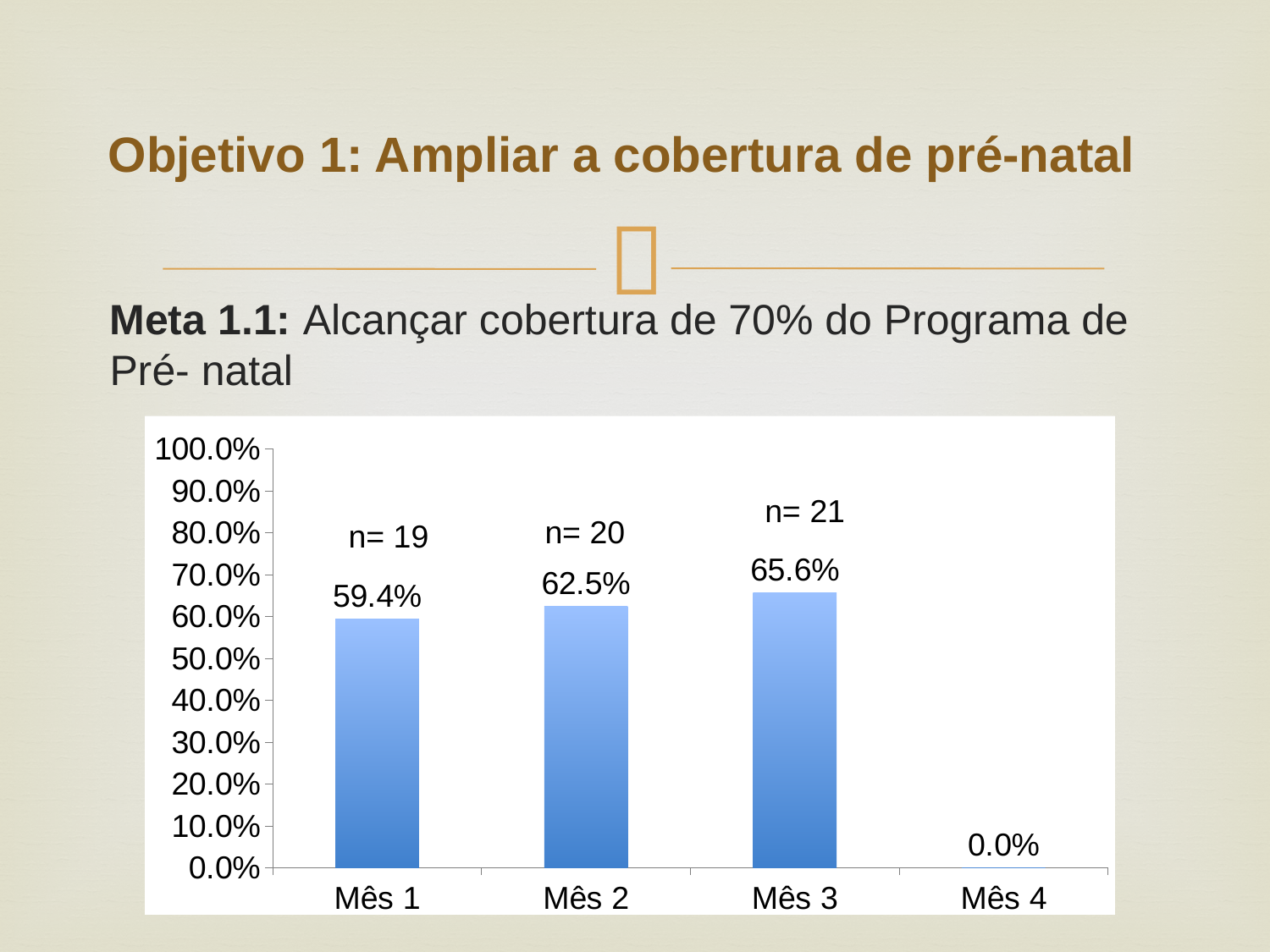
What is the value for Mês 3? 65.6% Is the value for Mês 3 greater or less than 70.0%? less What is the value for Mês 1? 59.4% What is the value for Mês 2? 62.5% What kind of chart is shown on the slide? bar chart Which is larger, the value for Mês 2 or the value for Mês 1? Mês 2 What is the value shown for Mês 4? 0.0% Which month has the highest value? Mês 3 How many categories are shown on the x axis? 4 What is the difference between the values for Mês 3 and Mês 1? 6.2% Which month has the lowest value? Mês 4 What is the n value annotated above the bar for Mês 2? n= 20